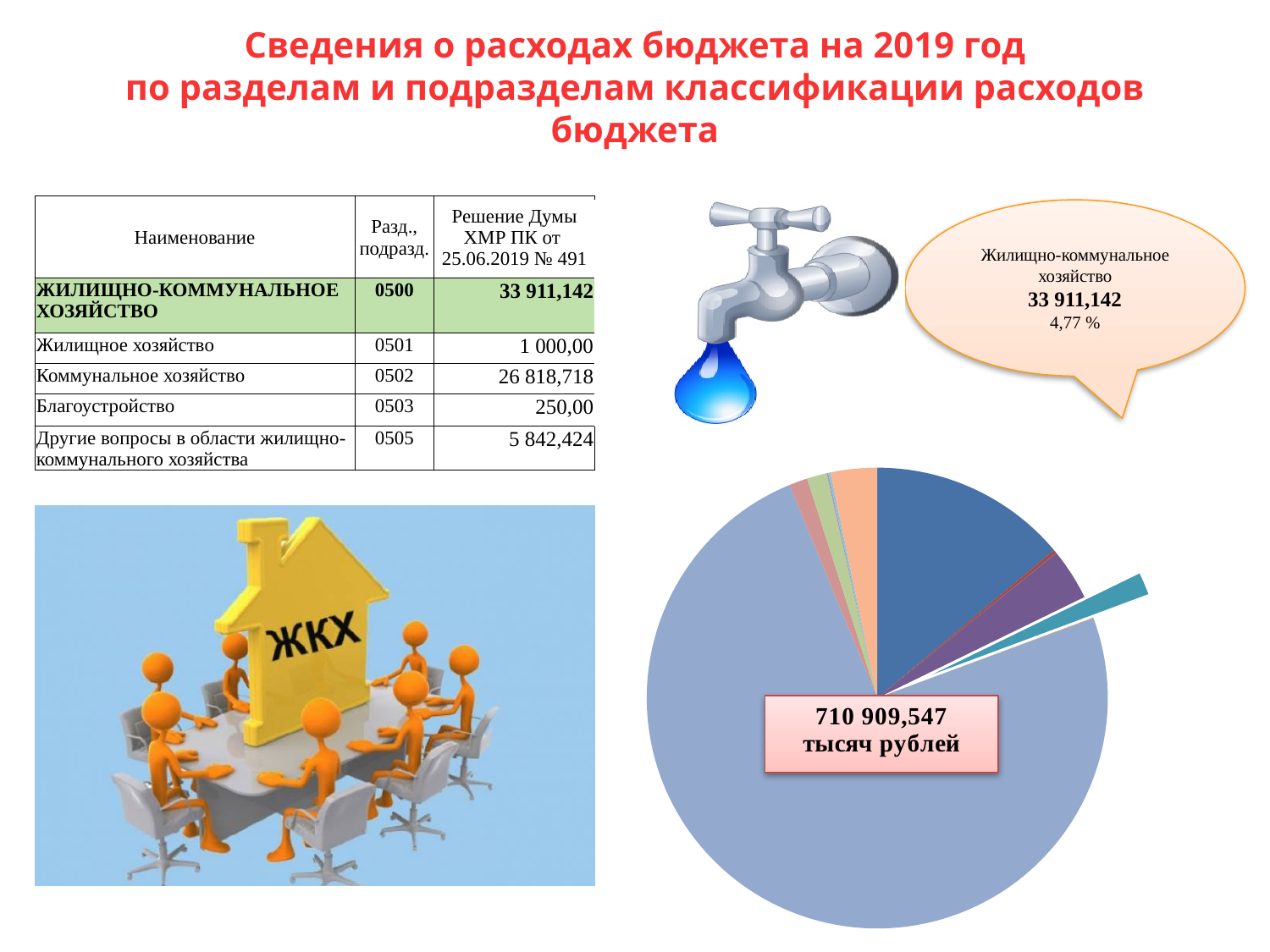
What total amount is printed in the label on the pie chart? 710 909,547 тысяч рублей Is the exploded (pulled-out) slice of the pie chart larger or smaller than the largest slice? smaller According to the callout on the pie chart, what is the value for Жилищно-коммунальное хозяйство? 33 911,142 Does the pie chart display a legend? No Is the share of Жилищно-коммунальное хозяйство in the pie chart greater or less than 10%? less According to the callout on the pie chart, what share of the budget does Жилищно-коммунальное хозяйство represent? 4,77 % What kind of chart is shown on the right side of the slide? pie chart